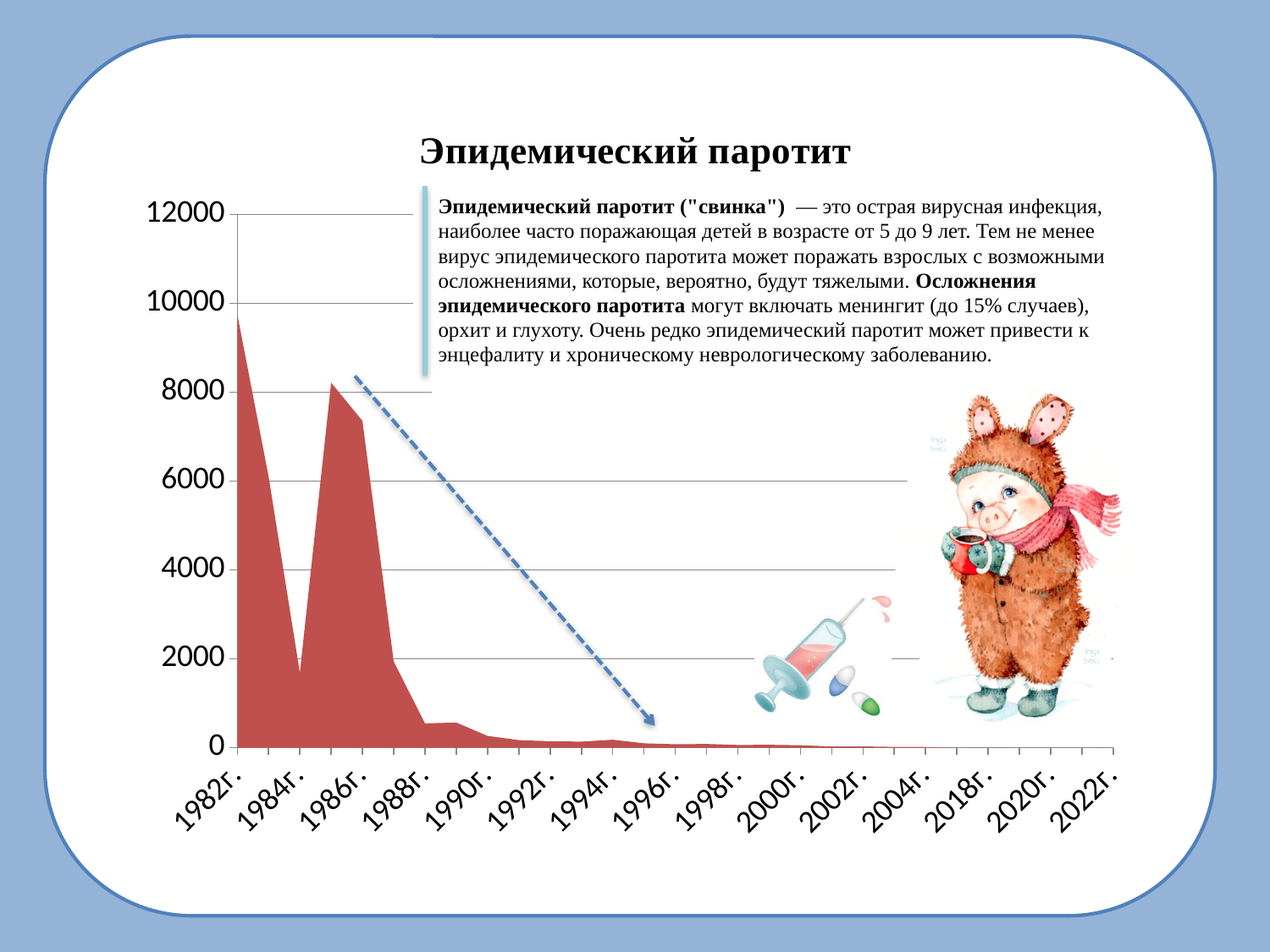
Which is larger, the value for 1984г. or the value for 1986г.? 1986г. What is the title of the slide containing the chart? Эпидемический паротит Is the value for 1982г. greater or less than 8000? greater What kind of chart is shown on the slide? area chart Is the value for 1988г. greater or less than 2000? less Is the value for 1984г. greater or less than 4000? less Which is larger, the value for 1982г. or the value for 1986г.? 1982г. Which year has the highest value in the chart? 1982г. Do the values in the chart generally rise or fall from 1982г. to 2022г.? fall How many year labels are shown on the x axis of the chart? 15